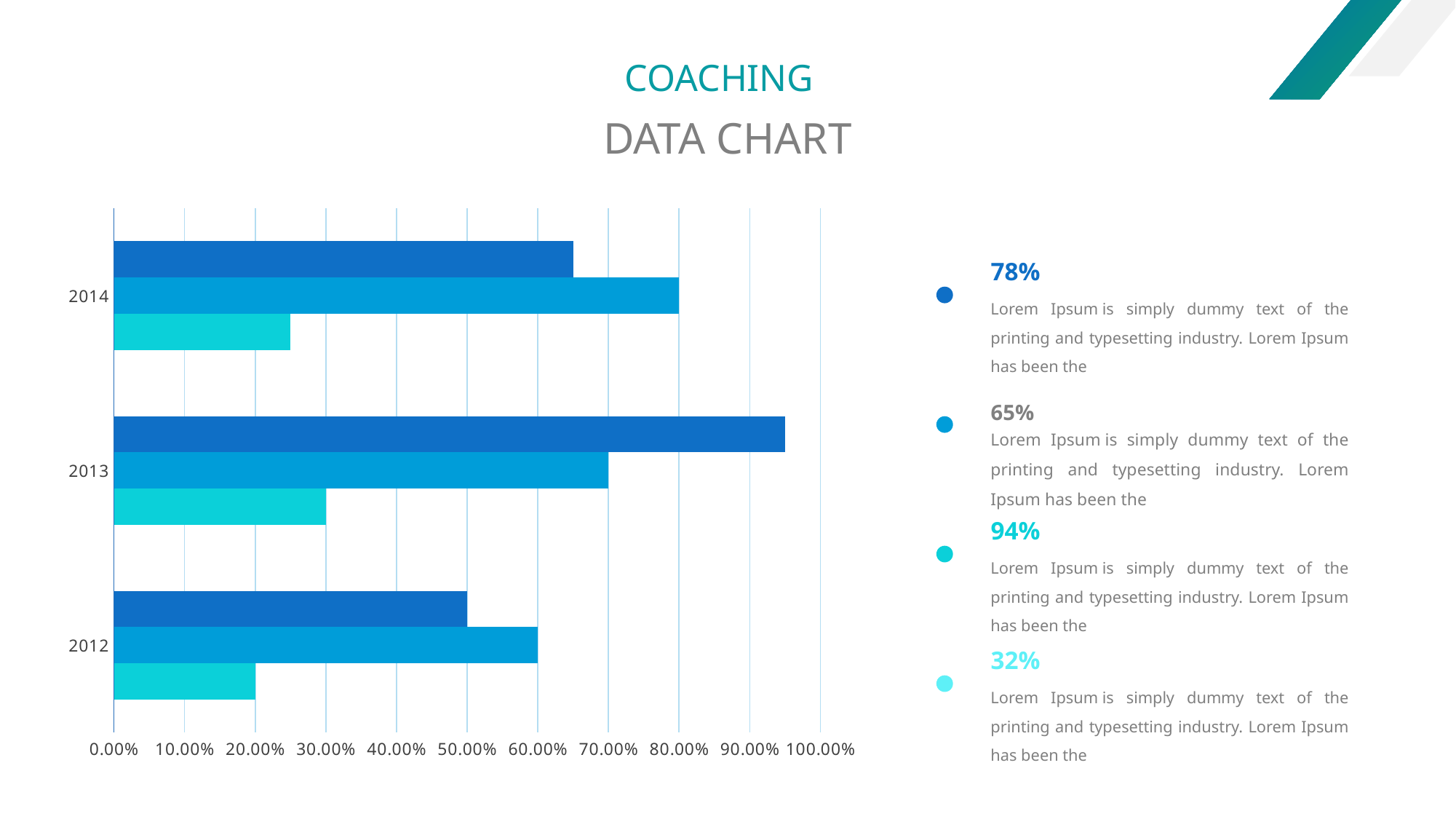
What is the value of the middle (medium blue) bar for 2014? 80.00% What is the value of the middle (medium blue) bar for 2012? 60.00% How many bars are plotted for each year in the chart? 3 What is the difference between the middle (medium blue) bar and the bottom (teal) bar for 2012? 40.00% Which year has the longest top (dark blue) bar? 2013 Is the value of the top (dark blue) bar for 2013 greater or less than 90.00%? greater What is the value of the top (dark blue) bar for 2012? 50.00% What is the value of the bottom (teal) bar for 2013? 30.00% Is the value of the bottom (teal) bar for 2014 greater or less than 30.00%? less How many years are shown on the vertical axis of the chart? 3 What type of chart is shown on the slide? Bar chart Which year has the shortest bottom (teal) bar? 2012